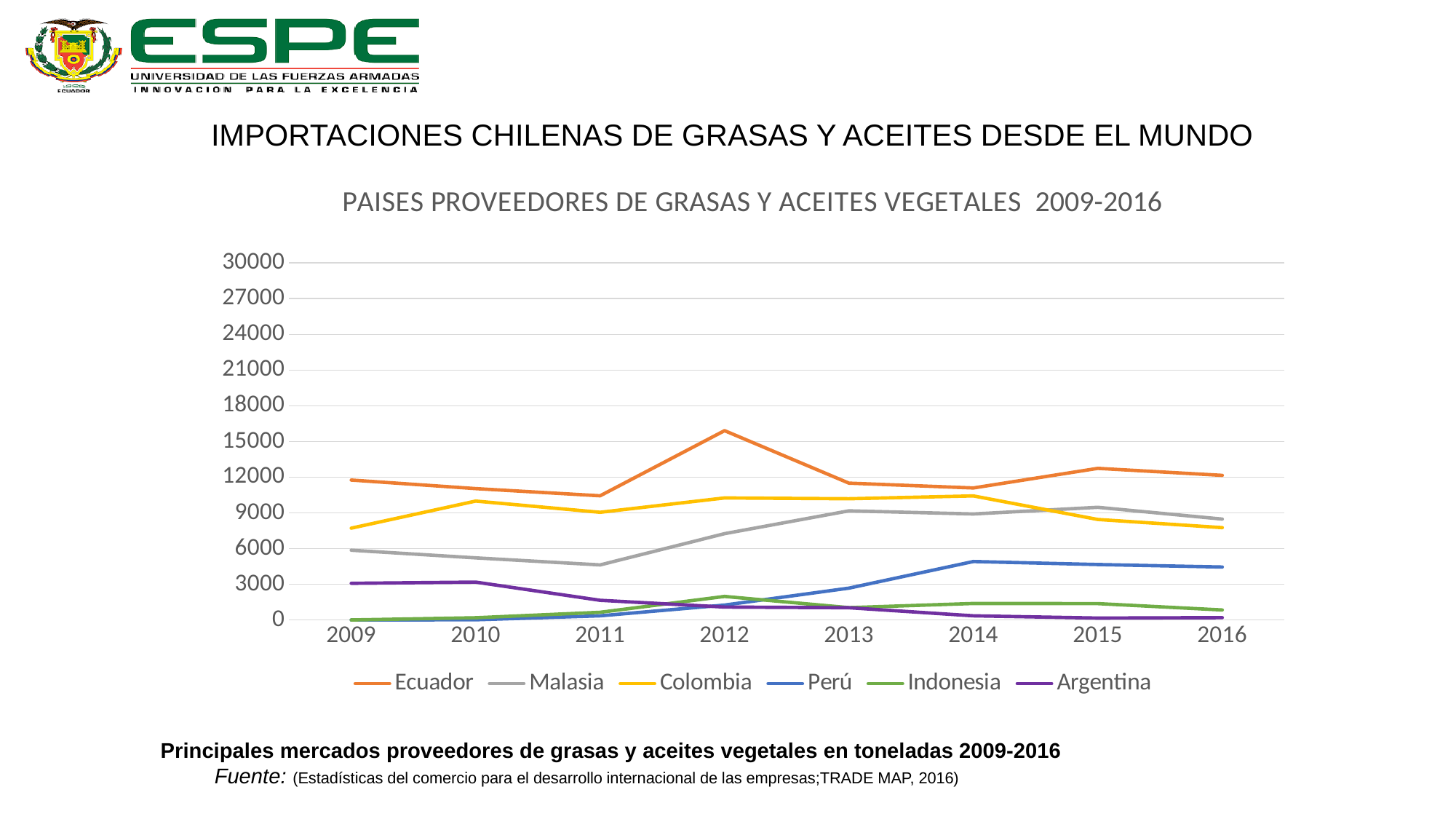
How many years are shown along the x axis? 8 What kind of chart is shown on the slide? line chart Is the value for Malasia in 2011 greater or less than 6000? less Which country had the highest value in 2012? Ecuador Is the value for Colombia in 2014 greater or less than 9000? greater Which country had the lowest value in 2016? Argentina What colour is the line for Ecuador? orange Does the value for Argentina rise or fall from 2010 to 2014? fall In 2014, which is larger: the value for Perú or the value for Argentina? Perú Is the value for Ecuador in 2012 greater or less than 15000? greater How many series does the legend list? 6 In 2010, which is larger: the value for Colombia or the value for Malasia? Colombia